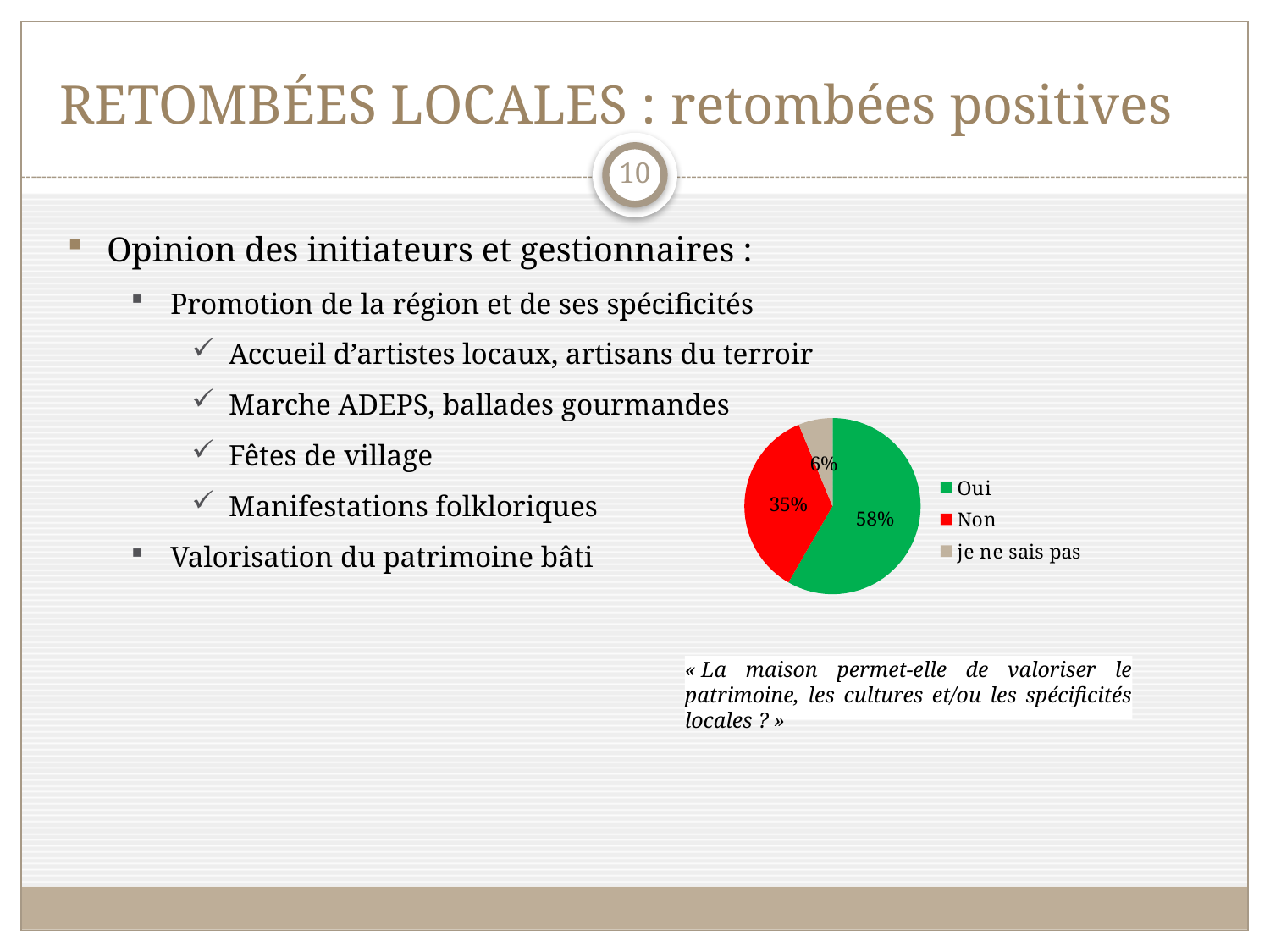
What is the difference in percentage points between "Oui" and "Non"? 23 How many entries does the legend list? 3 How many categories does the pie chart have? 3 What colour is the "Non" slice of the pie? red Which is larger, the share for "Non" or the share for "je ne sais pas"? Non What colour is the "Oui" slice of the pie? green What share of the pie does "Non" represent? 35% Which category has the smallest slice of the pie? je ne sais pas What share of the pie does "je ne sais pas" represent? 6% Which category has the largest slice of the pie? Oui What kind of chart is shown on the slide? pie chart What share of the pie does "Oui" represent? 58%